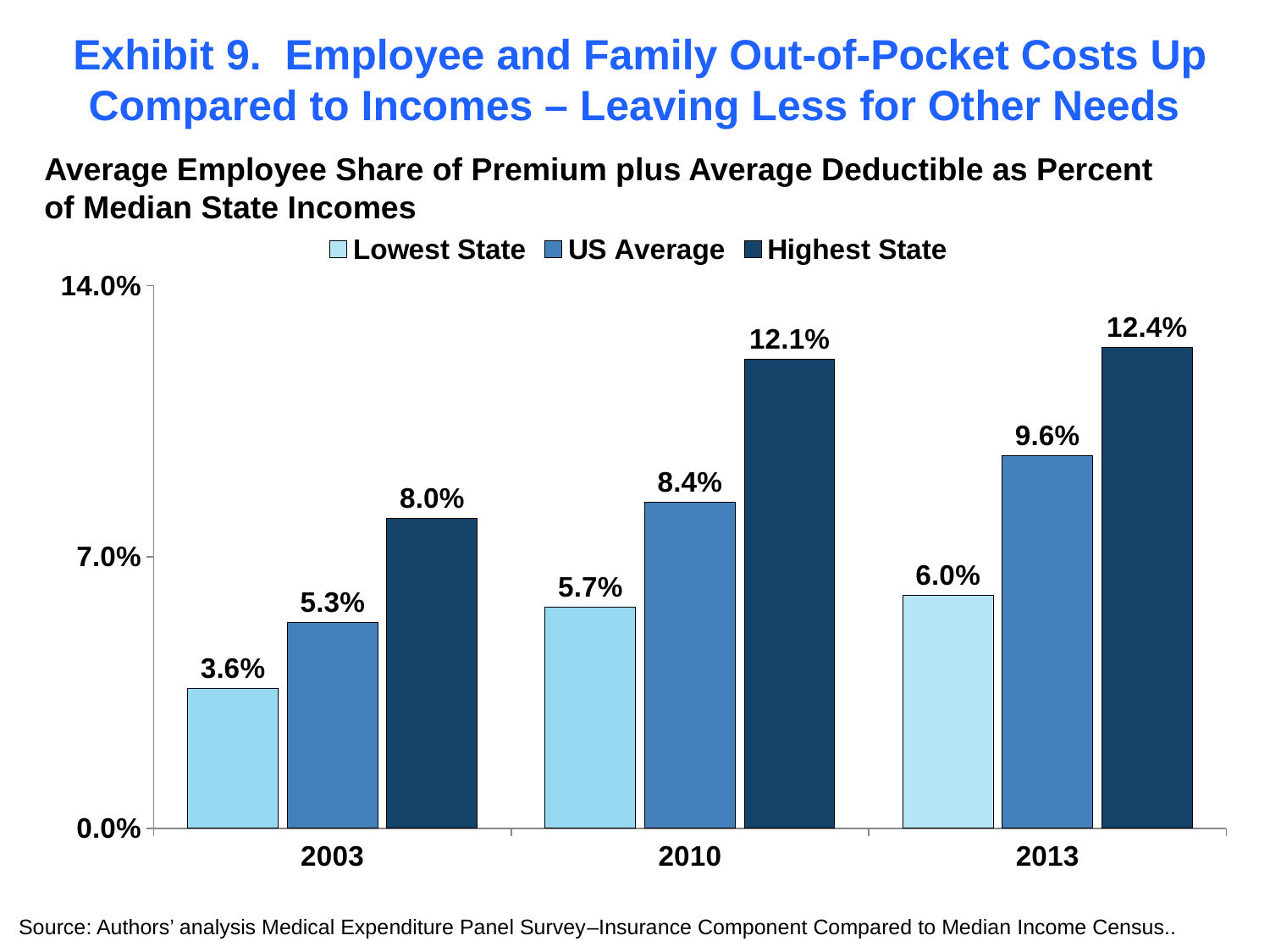
What kind of chart is shown on the slide? Bar chart What is the US Average value in 2010? 8.4% What is the value for Highest State in 2013? 12.4% Is the Highest State value in 2003 greater or less than 7.0%? greater In which year is the Lowest State value lowest? 2003 How many series does the legend list? 3 How many years are shown on the x axis? 3 Do the US Average values rise or fall from 2003 to 2013? Rise In which year is the US Average value highest? 2013 Which is larger: the US Average value in 2003 or the Lowest State value in 2013? Lowest State value in 2013 What is the value for Lowest State in 2003? 3.6% What is the difference between the Highest State and Lowest State values in 2010? 6.4%